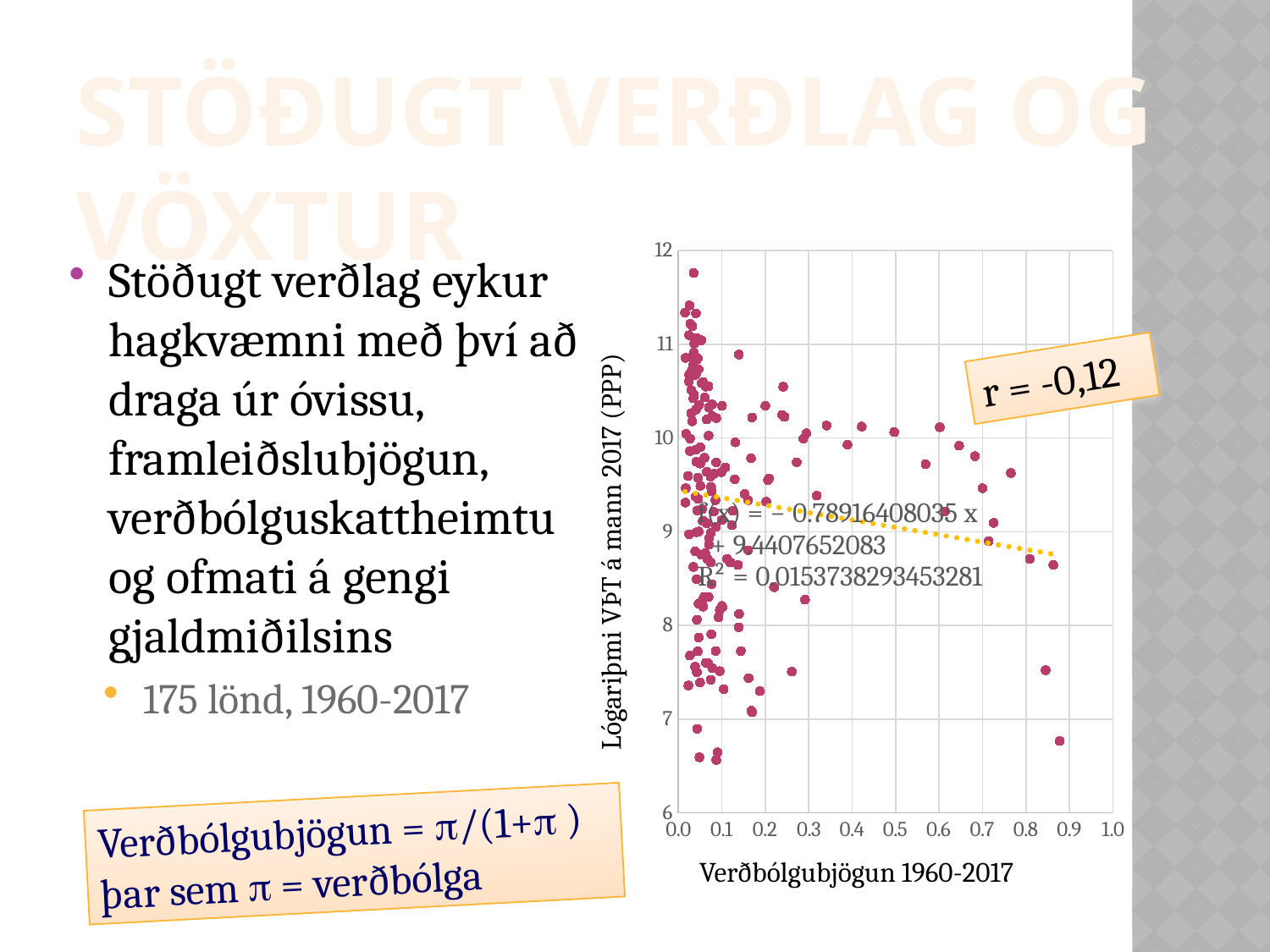
What kind of chart is shown on the slide? scatter chart What is the title of the y axis of the chart? Lógariþmi VÞT á mann 2017 (PPP) What is the intercept of the trendline equation printed on the chart? 9.4407652083 How many countries are plotted in the chart, according to the slide? 175 Is the y value of the highest point on the chart greater or less than 11? greater What correlation coefficient r is shown on the chart? r = -0,12 What is the title of the x axis of the chart? Verðbólgubjögun 1960-2017 What is the R² value printed on the chart? 0.0153738293453281 Does the dotted trendline rise or fall as the x value increases? fall What is the maximum value shown on the x axis? 1.0 What is the slope of the trendline equation printed on the chart? -0.78916408035 Is the y value of the point with the largest x value (near 0.9) greater or less than 7? less